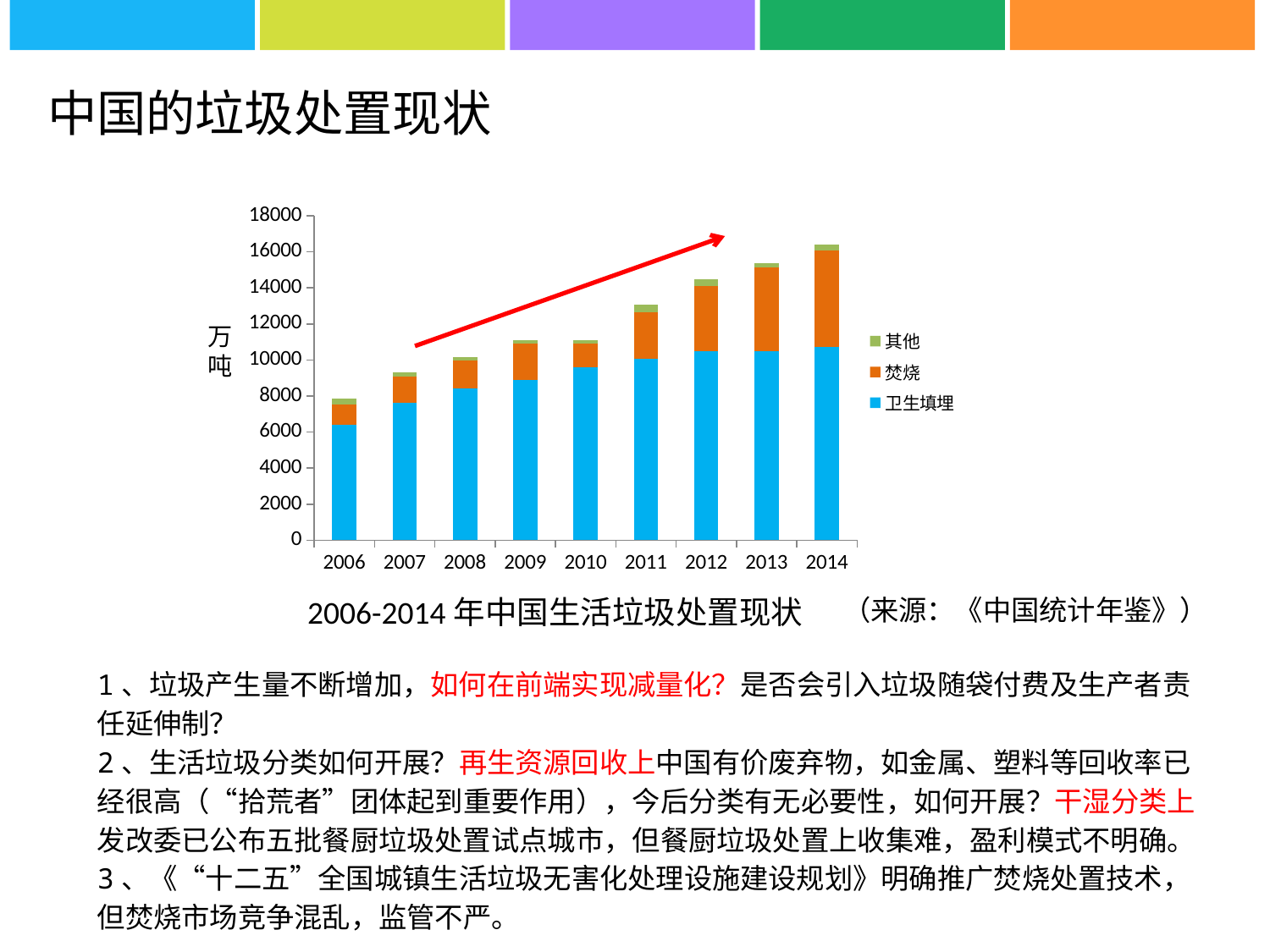
What unit is shown on the vertical axis of the chart? 万吨 Which year has the lowest total bar in the chart? 2006 Which year has the highest total bar in the chart? 2014 Is the total bar for 2014 greater or less than 16000? greater Which is larger, the total bar for 2014 or the total bar for 2006? 2014 How many series does the chart's legend list? 3 Is the total bar for 2011 greater or less than 12000? greater How many years are shown on the x axis of the chart? 9 Is the 卫生填埋 value for 2013 greater or less than 10000? greater Do the total bar heights rise or fall from 2006 to 2014? rise What kind of chart is shown on the slide? stacked bar chart